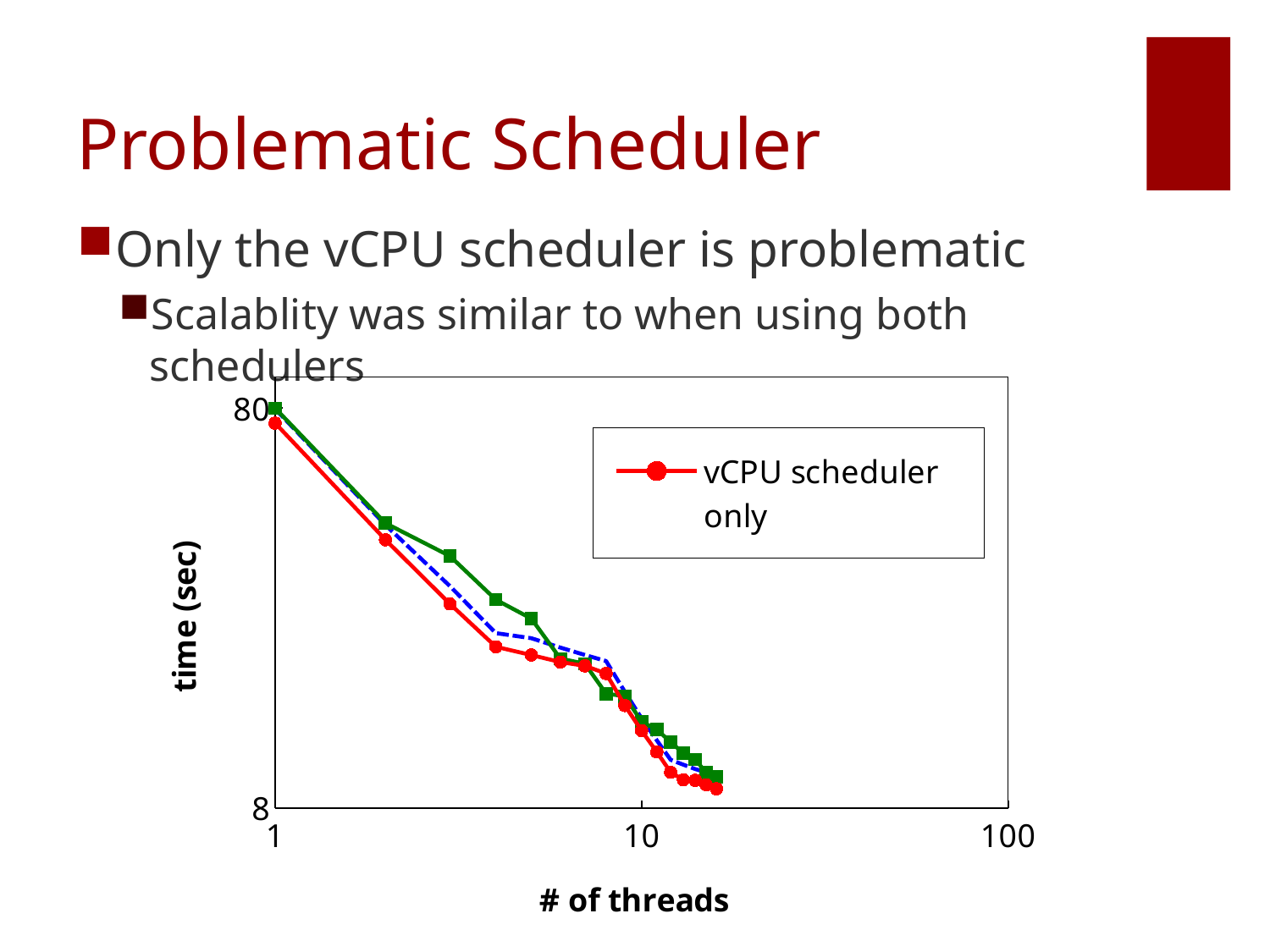
Is the time for vCPU scheduler only at its rightmost point greater or less than 80 sec? less Is the time for vCPU scheduler only at 1 thread greater or less than 8 sec? greater What kind of chart is shown on the slide? line chart How many series does the chart legend list? 1 Is the time for vCPU scheduler only at 10 threads greater or less than 80 sec? less At which number of threads is the time for vCPU scheduler only highest? 1 As the number of threads increases, does the time for vCPU scheduler only rise or fall? fall What is the label of the x axis of the chart? # of threads What series name appears in the chart legend? vCPU scheduler only